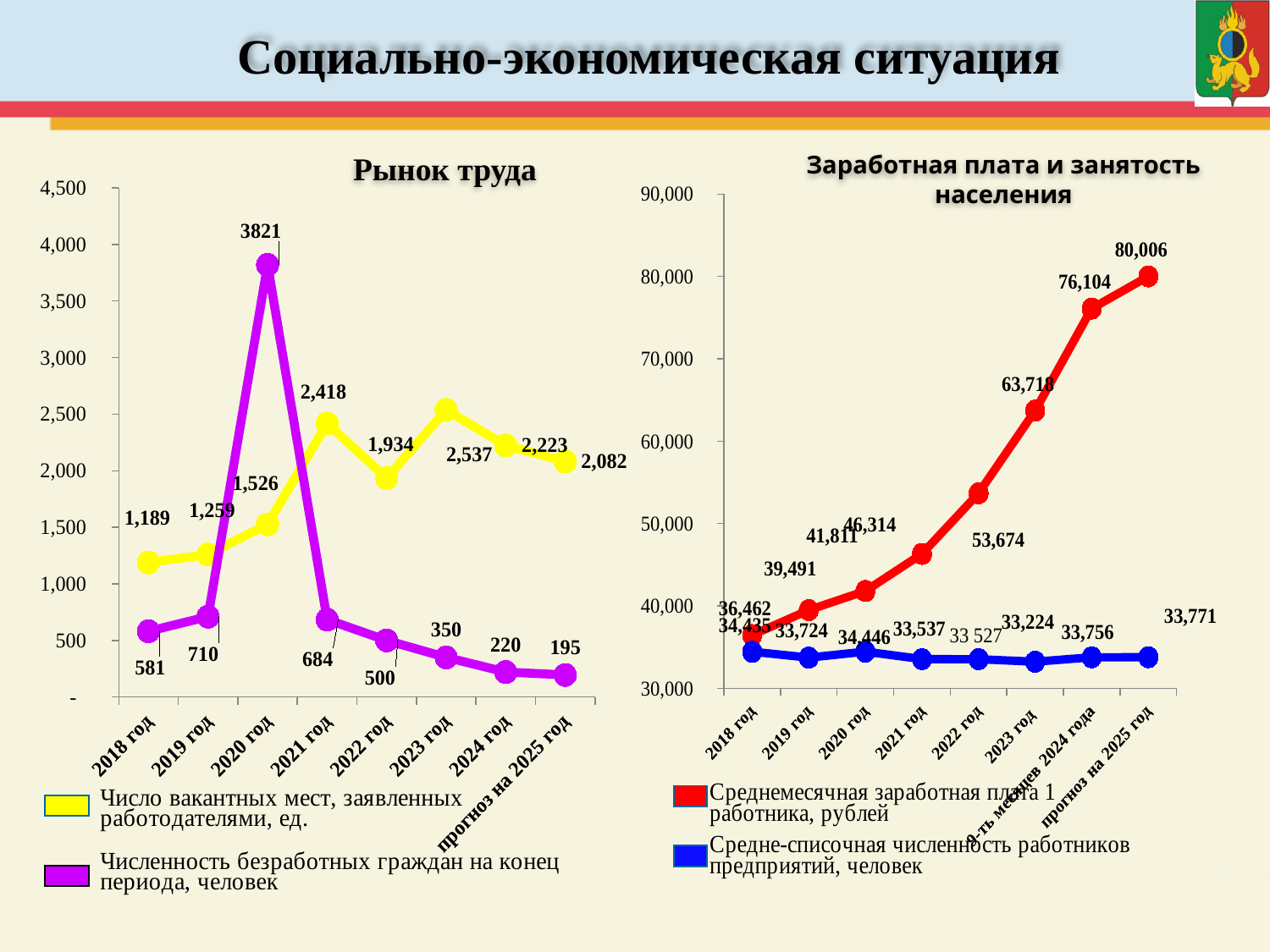
In the 'Рынок труда' chart, what is the difference between the number of vacancies in 2021 год and in 2022 год? 484 What type of chart is the 'Рынок труда' chart? line chart In the 'Заработная плата и занятость населения' chart, what is the difference between the average monthly salary in 2023 год and in 2022 год? 10,044 In the 'Заработная плата и занятость населения' chart, which year has the lowest average monthly salary? 2018 год In the 'Рынок труда' chart, how many series does the legend list? 2 In the 'Заработная плата и занятость населения' chart, what is the average number of employees (Средне-списочная численность работников) in 2018 год? 34,435 In the 'Рынок труда' chart, what is the number of vacancies (Число вакантных мест) in 2023 год? 2,537 In the 'Заработная плата и занятость населения' chart, how many data points does each series have? 8 In the 'Рынок труда' chart, which year has the highest number of unemployed citizens? 2020 год In the 'Заработная плата и занятость населения' chart, what is the average monthly salary (Среднемесячная заработная плата) for прогноз на 2025 год? 80,006 In the 'Рынок труда' chart, does the number of unemployed citizens rise or fall from 2021 год to прогноз на 2025 год? fall In the 'Рынок труда' chart, what is the number of unemployed citizens (Численность безработных граждан) in 2020 год? 3821